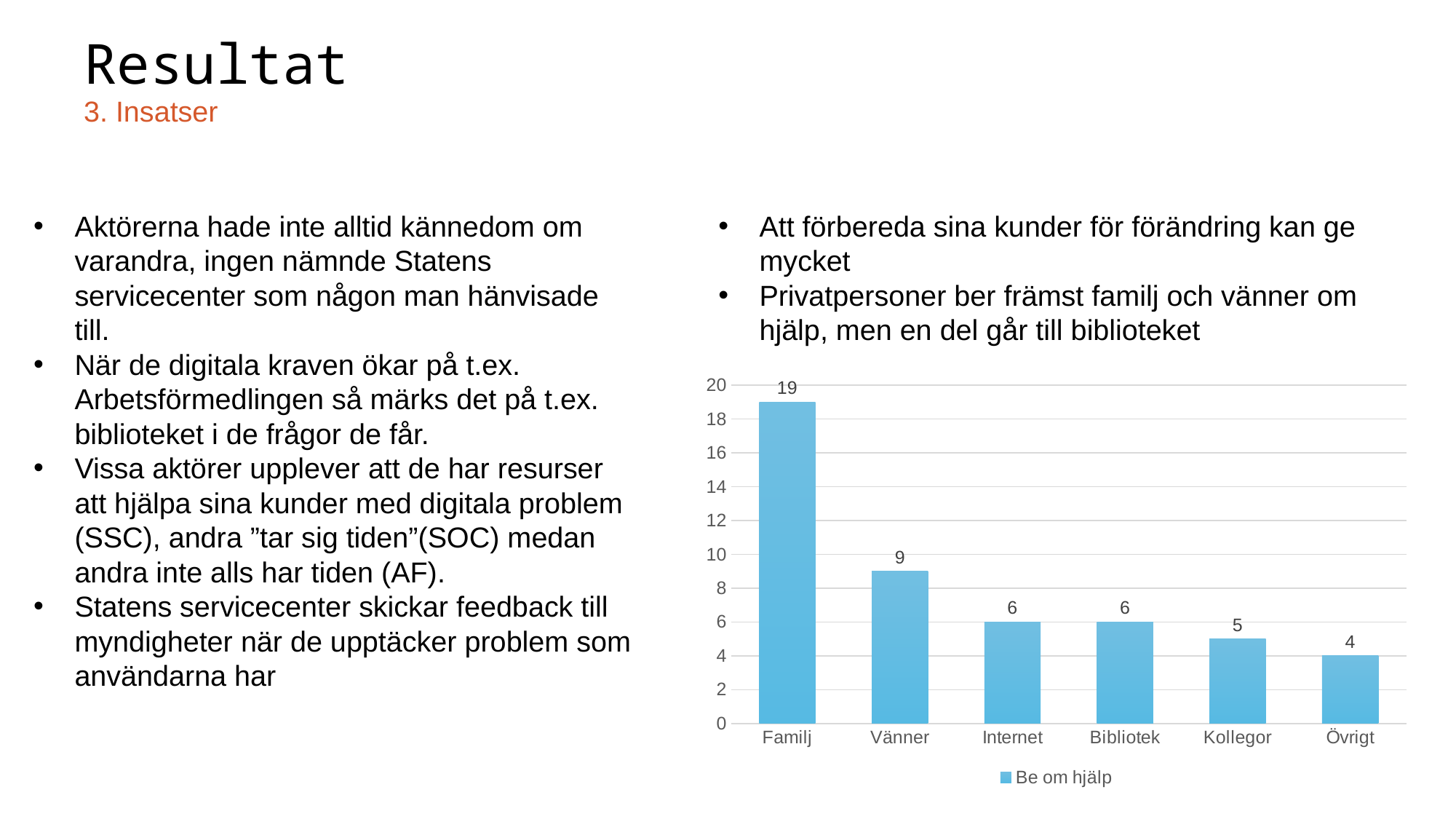
Is the value for Familj greater or less than 10? greater What is the difference between the values for Familj and Vänner? 10 Which is larger, the value for Vänner or the value for Internet? Vänner How many categories are shown on the x axis? 6 Which category has the highest value? Familj What is the value for Familj? 19 What is the value for Vänner? 9 What is the difference between the values for Bibliotek and Övrigt? 2 What is the value for Kollegor? 5 What kind of chart is shown on the slide? bar chart What series name does the legend show? Be om hjälp Which category has the lowest value? Övrigt